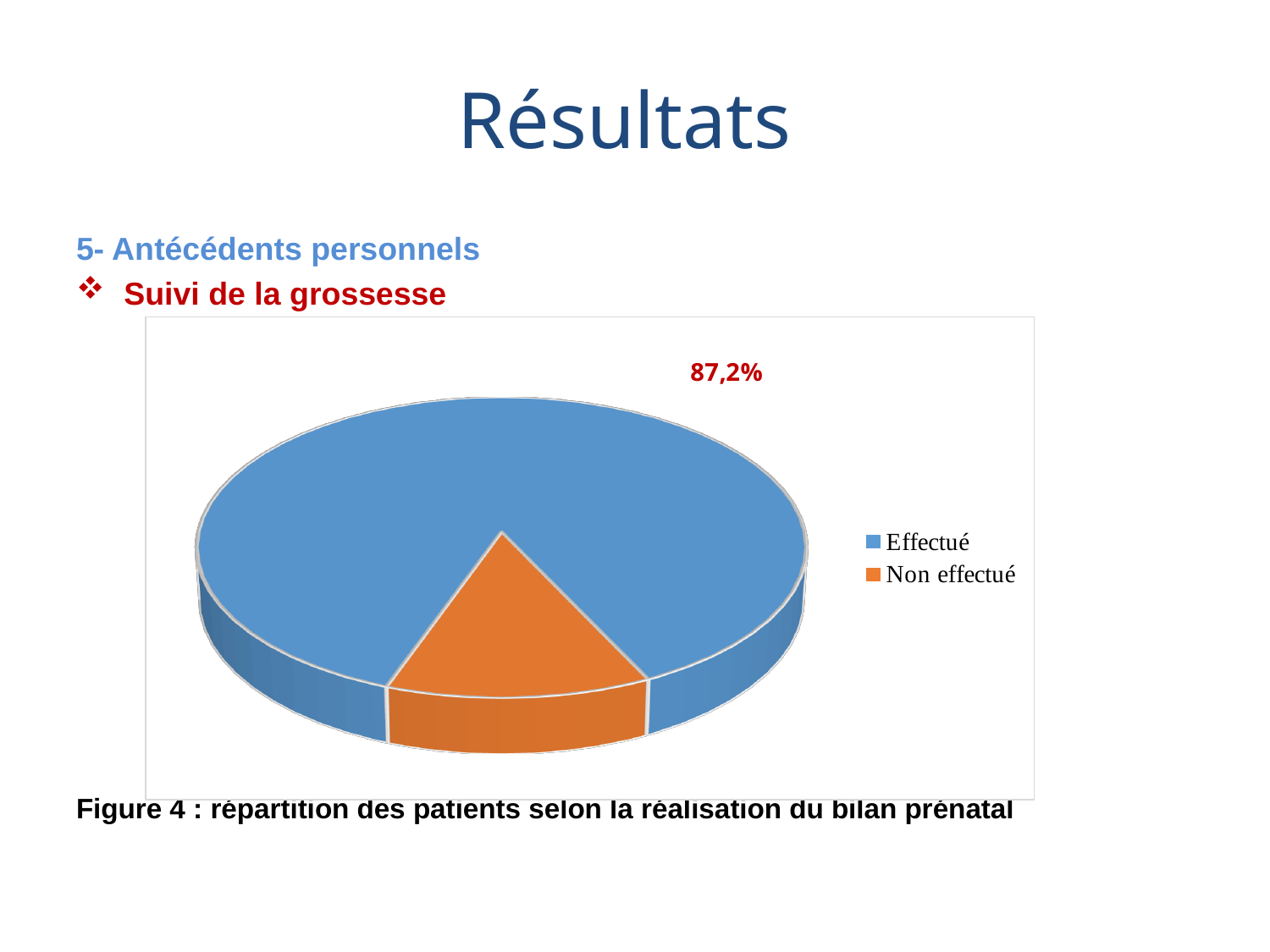
What is the figure caption below the pie chart? Figure 4 : répartition des patients selon la réalisation du bilan prénatal Which slice is larger in the pie chart, "Effectué" or "Non effectué"? Effectué What kind of chart is shown on the slide? pie chart Which category has the smallest slice in the pie chart? Non effectué How many slices does the pie chart have? 2 Which category has the largest slice in the pie chart? Effectué What colour is the "Non effectué" slice in the pie chart? orange What percentage is shown for the "Effectué" slice of the pie chart? 87,2% How many entries does the legend of the pie chart list? 2